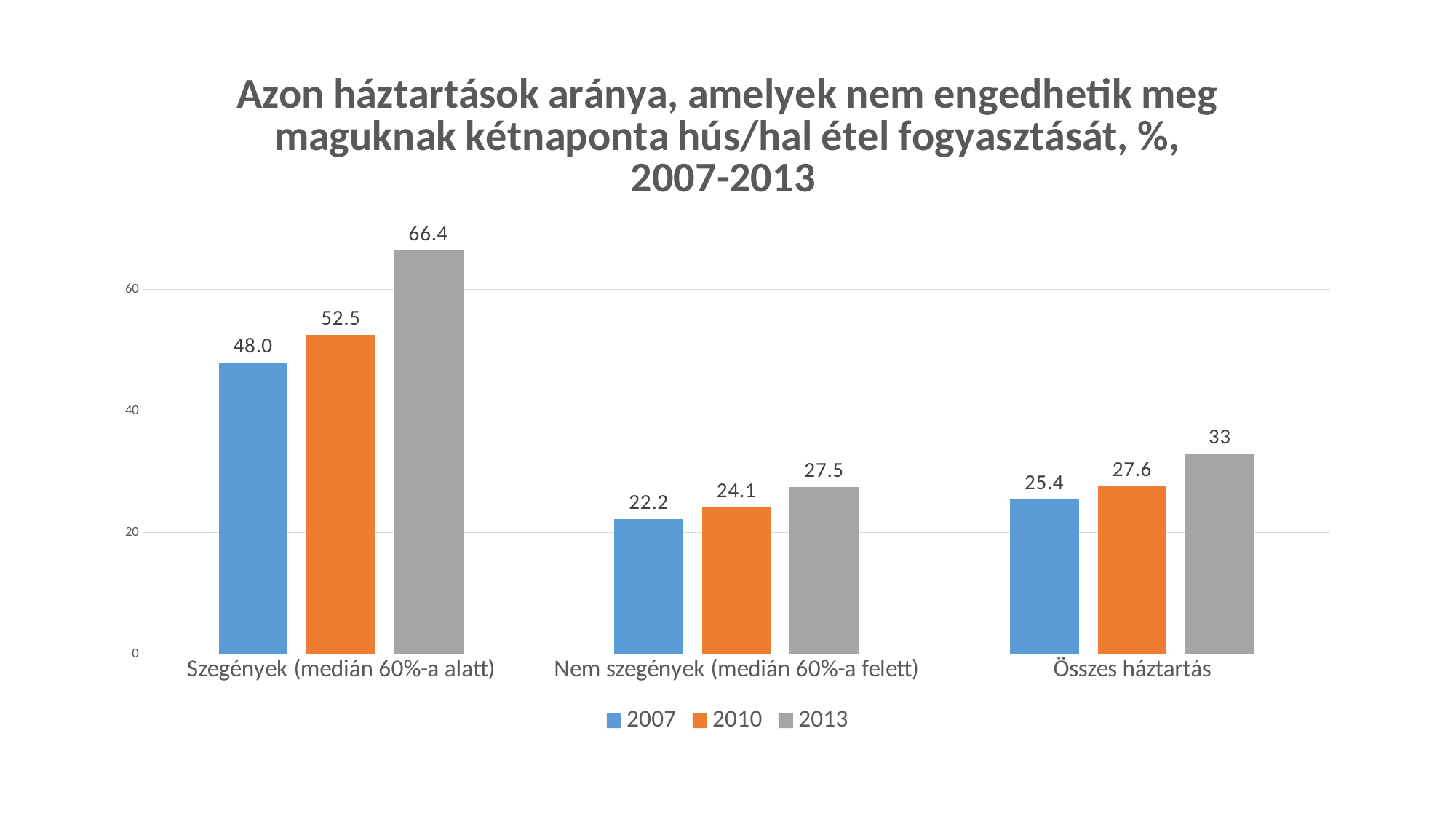
What kind of chart is shown on the slide? bar chart What is the difference between the 2013 and 2007 values for Szegények (medián 60%-a alatt)? 18.4 Do the values for Összes háztartás rise or fall from 2007 to 2013? rise Is the 2010 value for Szegények (medián 60%-a alatt) greater or less than 40? greater What is the value for Összes háztartás in 2010? 27.6 Which category has the lowest value in 2007? Nem szegények (medián 60%-a felett) What is the value for Szegények (medián 60%-a alatt) in 2013? 66.4 How many series does the legend list? 3 Which category has the highest value in 2013? Szegények (medián 60%-a alatt) What is the value for Nem szegények (medián 60%-a felett) in 2007? 22.2 How many categories are shown on the x axis? 3 Which is larger for Összes háztartás: the 2010 value or the 2013 value? 2013